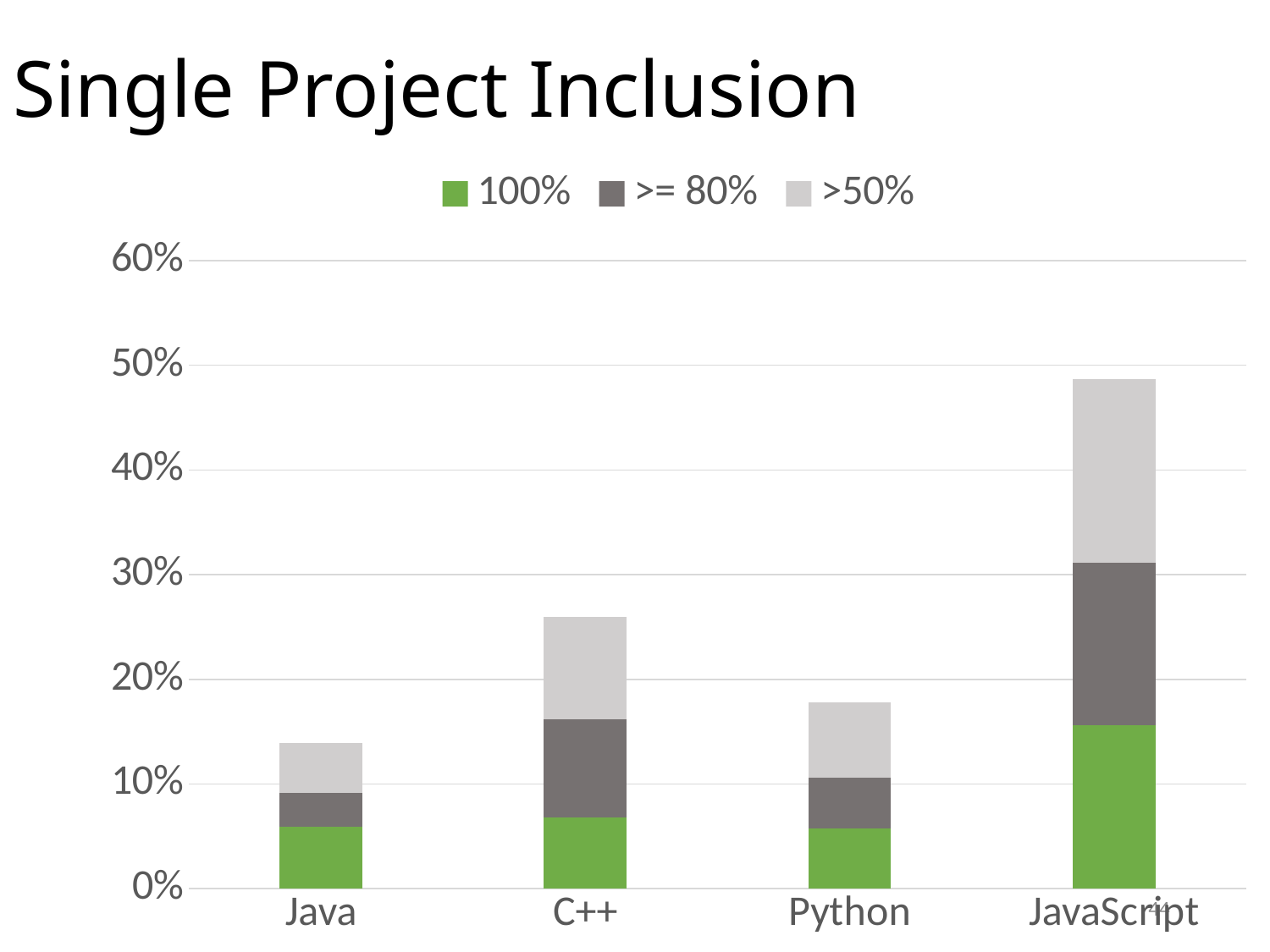
What is the title of the slide containing the chart? Single Project Inclusion Which language has the shortest stacked bar? Java How many programming languages are shown on the x axis? 4 Which series is shown in green in the legend? 100% Is the total stacked bar for Python greater or less than 20%? less Is the total stacked bar for JavaScript greater or less than 40%? greater Which language has the tallest stacked bar? JavaScript What kind of chart is shown on the slide? Stacked bar chart How many series does the legend list? 3 Which has the taller stacked bar, C++ or Python? C++ Is the total stacked bar for C++ greater or less than 20%? greater